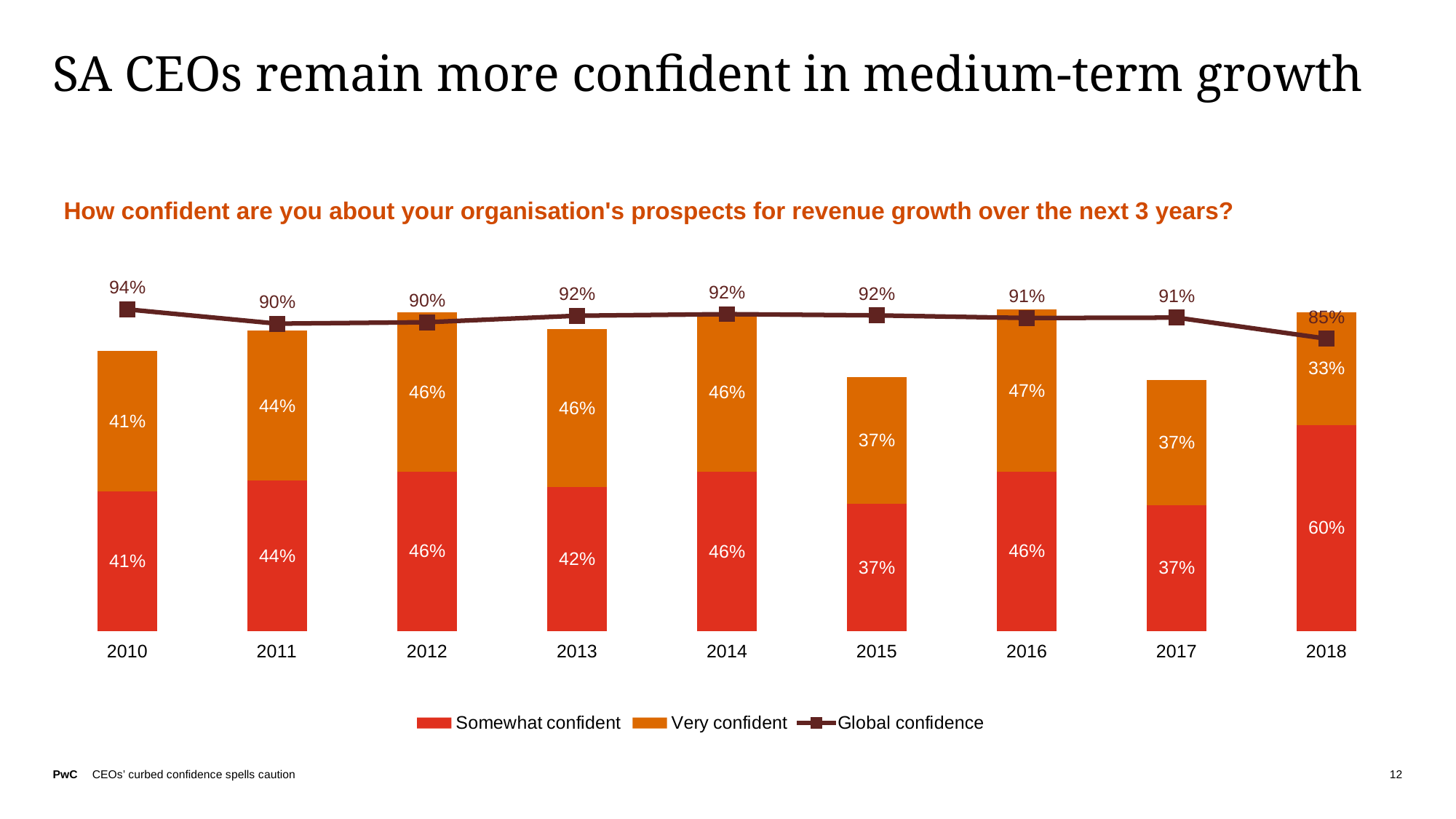
What is the total of the stacked bar for 2015? 74% What is the difference between the Global confidence values for 2010 and 2018? 9% Which year has the lowest Global confidence value? 2018 Which series is shown as a line rather than bars? Global confidence What kind of chart is this? Stacked bar chart with a line Which year has the highest Somewhat confident value? 2018 How many series does the legend list? 3 What is the Very confident value for 2016? 47% Which is larger, the Very confident value for 2013 or the Very confident value for 2015? 2013 What is the Global confidence value for 2010? 94% How many years are shown on the x axis? 9 What is the Somewhat confident value for 2018? 60%